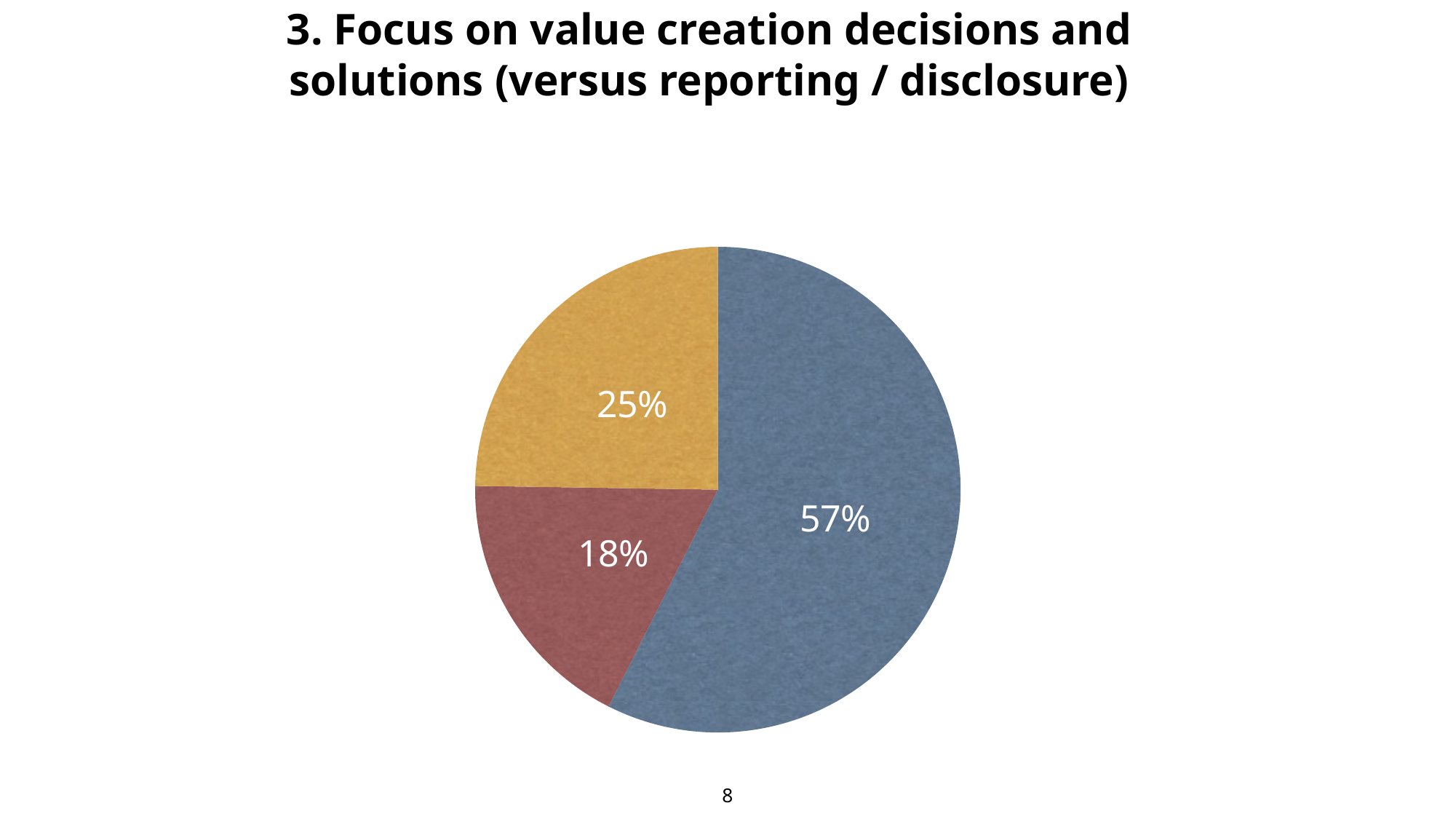
Which colour slice is the smallest in the pie chart? red What percentage is shown on the blue slice of the pie chart? 57% What is the difference in percentage points between the orange slice and the red slice? 7 How many slices does the pie chart have? 3 What is the difference in percentage points between the blue slice and the orange slice? 32 What is the title of the slide containing the pie chart? 3. Focus on value creation decisions and solutions (versus reporting / disclosure) What percentage is shown on the red slice of the pie chart? 18% What kind of chart is shown on the slide? pie chart Which is larger, the orange slice or the red slice? orange slice Which colour slice is the largest in the pie chart? blue Is the blue slice's share greater or less than 50%? greater What percentage is shown on the orange slice of the pie chart? 25%